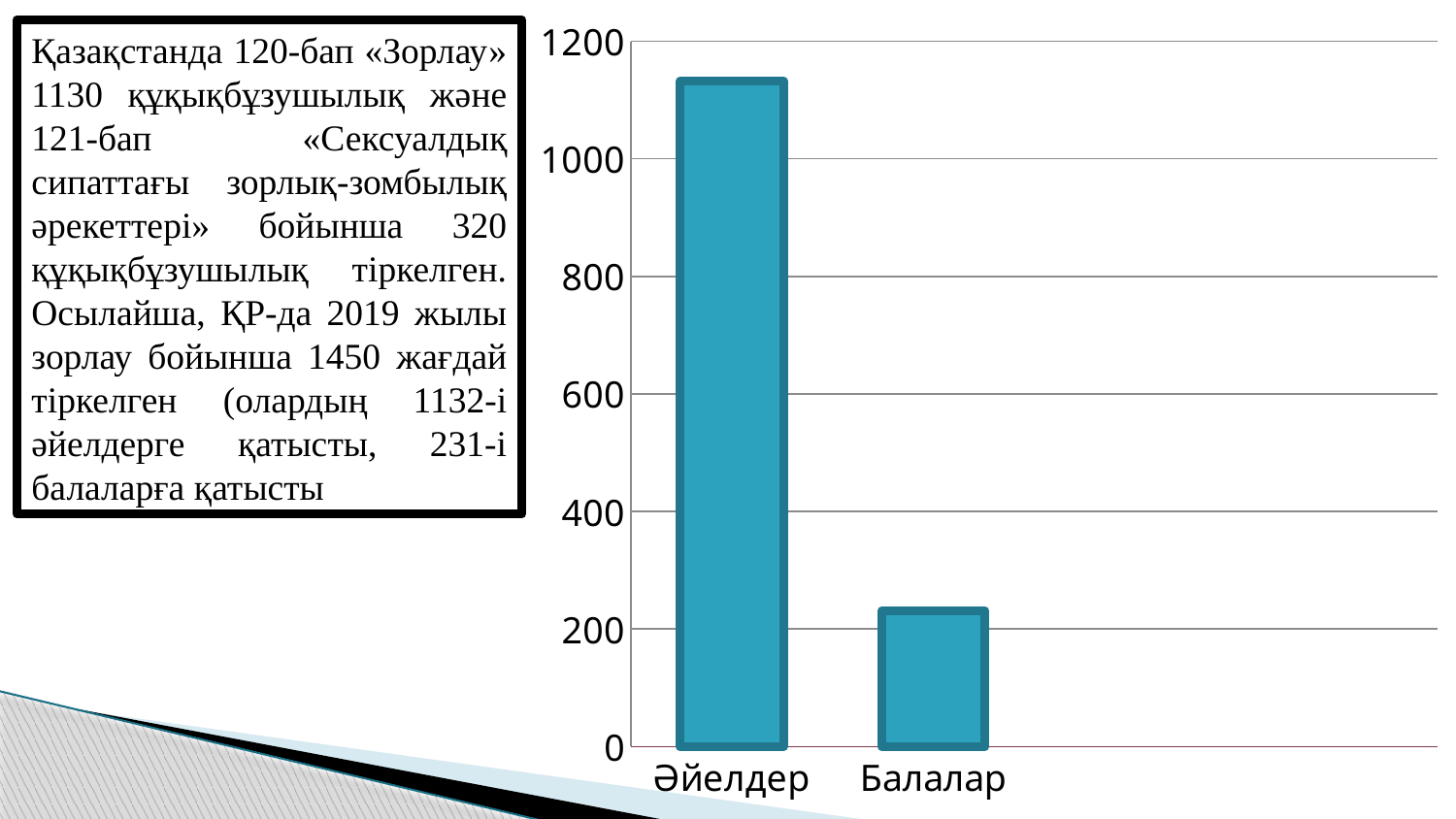
Do the bar values rise or fall from left to right along the x axis? fall Is the value for Балалар greater or less than 200? greater Is the value for Балалар greater or less than 400? less What kind of chart is shown on the slide? bar chart What is the maximum value shown on the vertical axis? 1200 Which category has the highest bar? Әйелдер How many categories are plotted on the chart? 2 What is the label of the first category on the x axis? Әйелдер Which is larger, the value for Әйелдер or the value for Балалар? Әйелдер Which category has the lowest bar? Балалар Is the value for Әйелдер greater or less than 1200? less